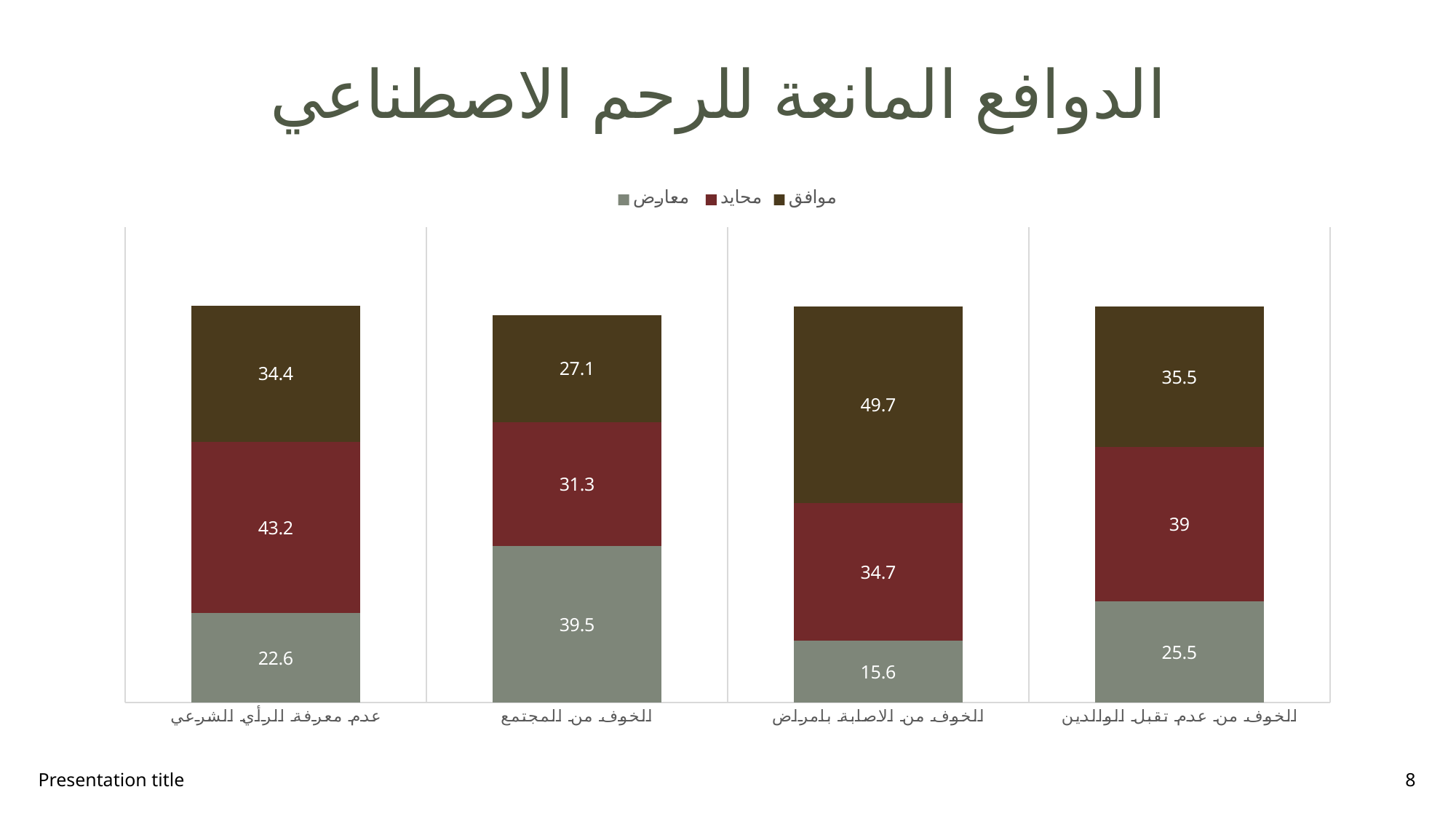
Which category has the highest value for موافق? الخوف من الاصابة بامراض What is the value of معارض for الخوف من المجتمع? 39.5 What is the value of موافق for الخوف من الاصابة بامراض? 49.7 What is the difference between the محايد value for عدم معرفة الرأي الشرعي and the محايد value for الخوف من المجتمع? 11.9 What is the value of محايد for الخوف من عدم تقبل الوالدين? 39 What type of chart is shown on the slide? stacked bar chart Which category has the lowest value for معارض? الخوف من الاصابة بامراض What is the title of the chart on the slide? الدوافع المانعة للرحم الاصطناعي How many series does the legend list? 3 What is the total of the stacked bar for الخوف من المجتمع? 97.9 How many categories are shown on the x axis? 4 Which is larger: the موافق value for الخوف من عدم تقبل الوالدين or the موافق value for عدم معرفة الرأي الشرعي? الخوف من عدم تقبل الوالدين